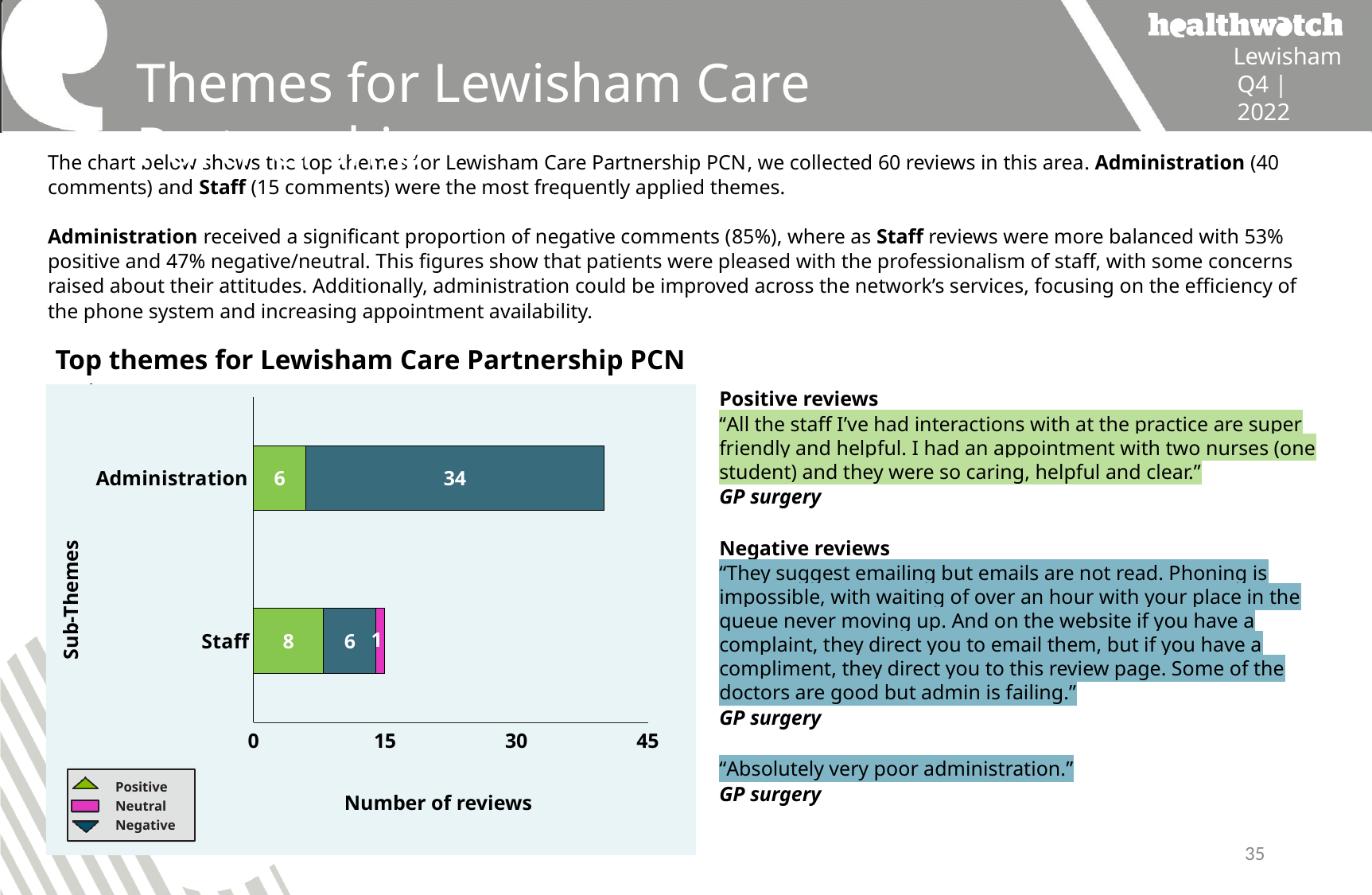
What is the number of positive reviews for Administration? 6 What is the total number of reviews in the Administration bar? 40 What is the total number of reviews in the Staff bar? 15 Which sub-theme has the higher total number of reviews? Administration How many sub-themes are plotted on the chart? 2 What is the number of neutral reviews for Staff? 1 What is the difference between the negative reviews for Administration and the negative reviews for Staff? 28 What kind of chart is shown on the slide? Stacked bar chart What is the number of positive reviews for Staff? 8 What is the title of the chart? Top themes for Lewisham Care Partnership PCN What is the number of negative reviews for Administration? 34 How many series does the chart legend list? 3